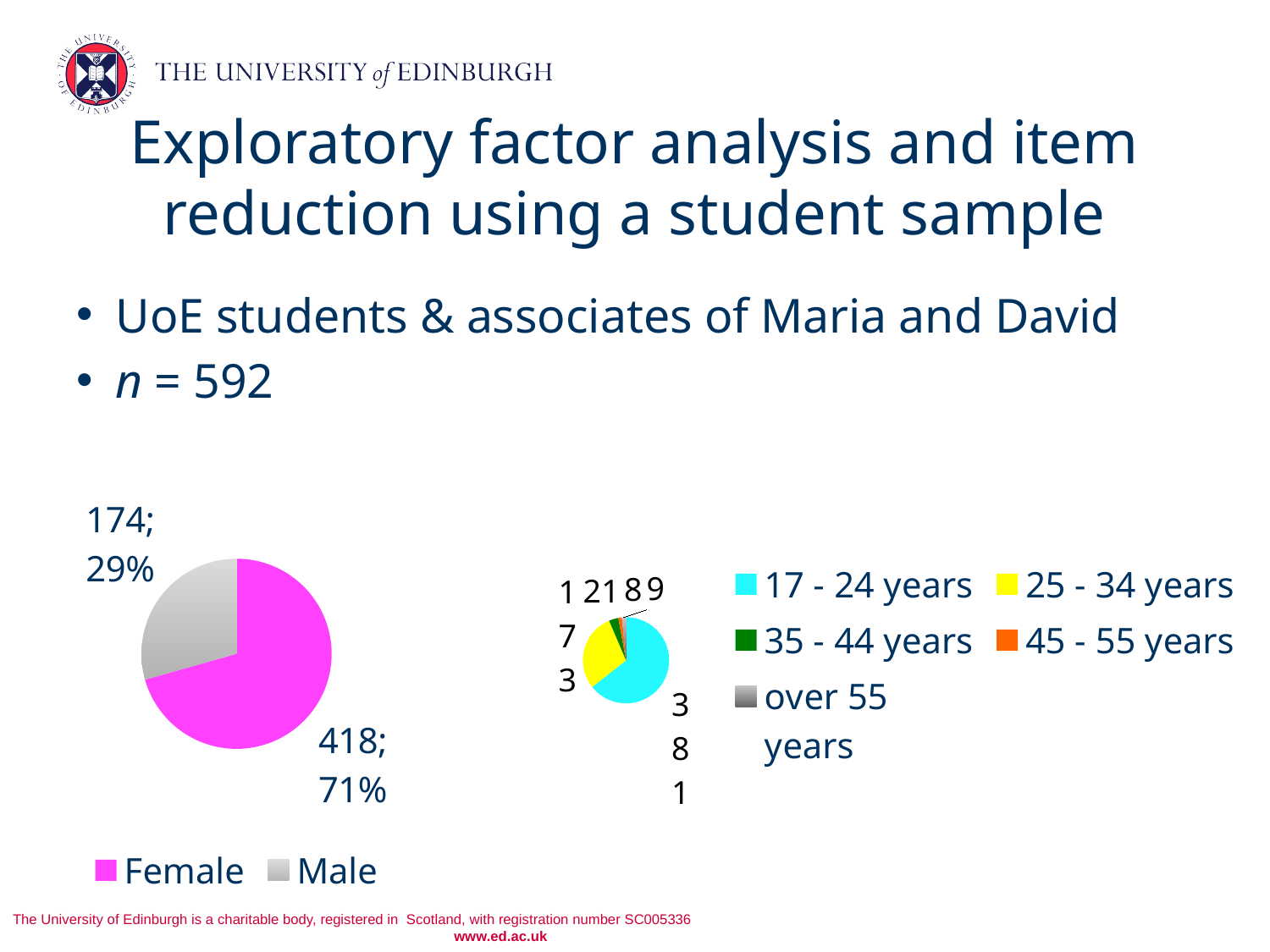
In the left pie chart, what percentage share does the Female slice have? 71% In the left pie chart, what is the total of the Female and Male counts? 592 In the left pie chart, how many respondents are Male? 174 In the left pie chart, how many respondents are Female? 418 What type of chart is the left chart showing Female and Male? Pie chart How many categories does the legend of the left pie chart list? 2 In the left pie chart, what percentage share does the Male slice have? 29% How many age groups does the legend of the right pie chart list? 5 In the left pie chart, which category has the larger slice, Female or Male? Female In the left pie chart, which category is the smallest? Male In the left pie chart, what is the difference between the Female and Male counts? 244 In the right pie chart, which age group has the largest slice? 17 - 24 years